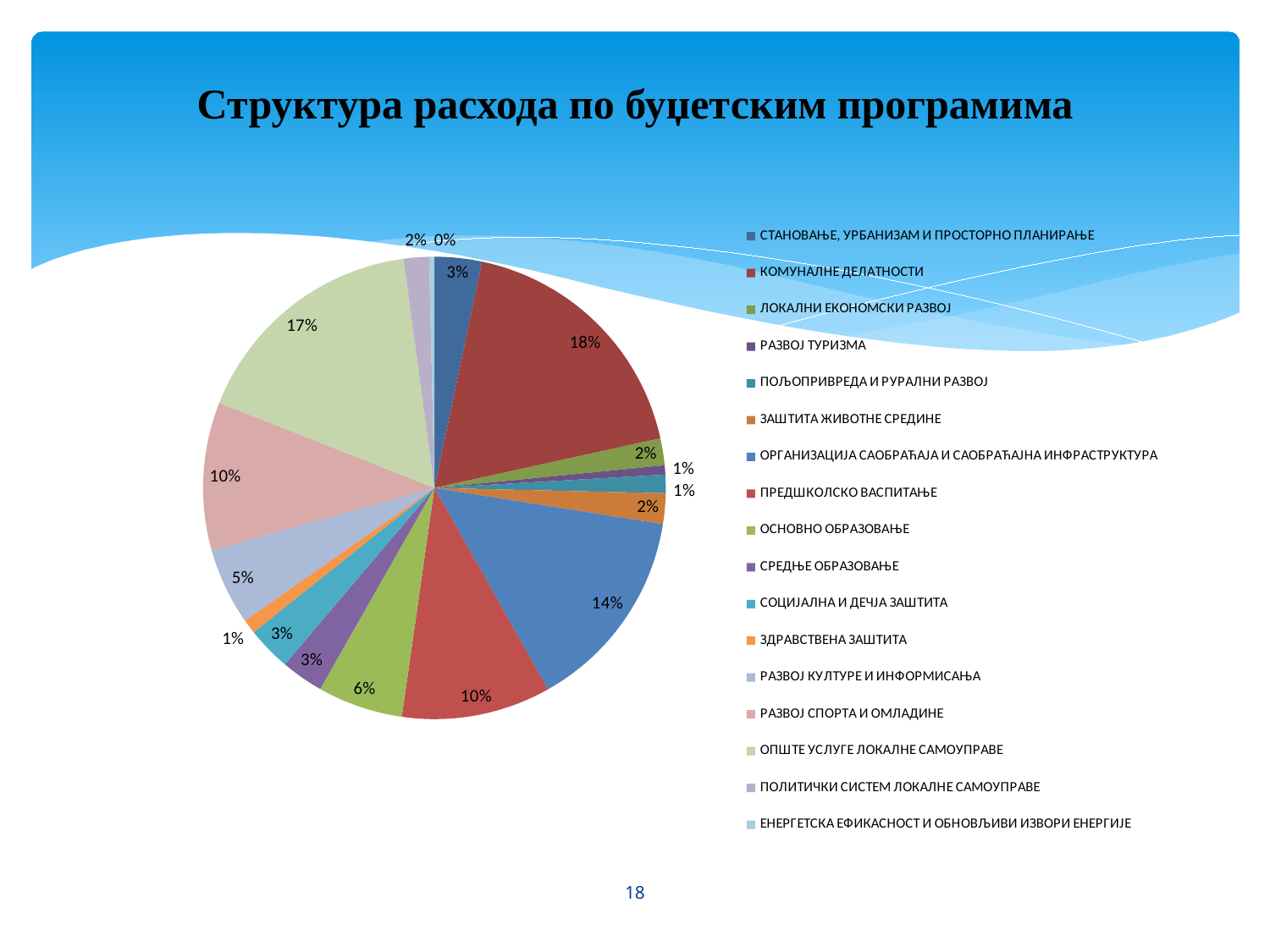
Which has a larger share, ПРЕДШКОЛСКО ВАСПИТАЊЕ or ОСНОВНО ОБРАЗОВАЊЕ? ПРЕДШКОЛСКО ВАСПИТАЊЕ Which budget programme has the largest share of expenditure? КОМУНАЛНЕ ДЕЛАТНОСТИ What is the share of ОПШТЕ УСЛУГЕ ЛОКАЛНЕ САМОУПРАВЕ? 17% How many entries does the legend list? 17 What is the share of РАЗВОЈ КУЛТУРЕ И ИНФОРМИСАЊА? 5% What is the share of ОСНОВНО ОБРАЗОВАЊЕ? 6% Which programme has the smallest share, shown as 0%? ЕНЕРГЕТСКА ЕФИКАСНОСТ И ОБНОВЉИВИ ИЗВОРИ ЕНЕРГИЈЕ What is the title of the chart? Структура расхода по буџетским програмима What is the share of КОМУНАЛНЕ ДЕЛАТНОСТИ? 18% What is the difference in percentage points between the shares of КОМУНАЛНЕ ДЕЛАТНОСТИ and ОРГАНИЗАЦИЈА САОБРАЋАЈА И САОБРАЋАЈНА ИНФРАСТРУКТУРА? 4 percentage points What kind of chart is shown on the slide? pie chart What is the share of ОРГАНИЗАЦИЈА САОБРАЋАЈА И САОБРАЋАЈНА ИНФРАСТРУКТУРА? 14%